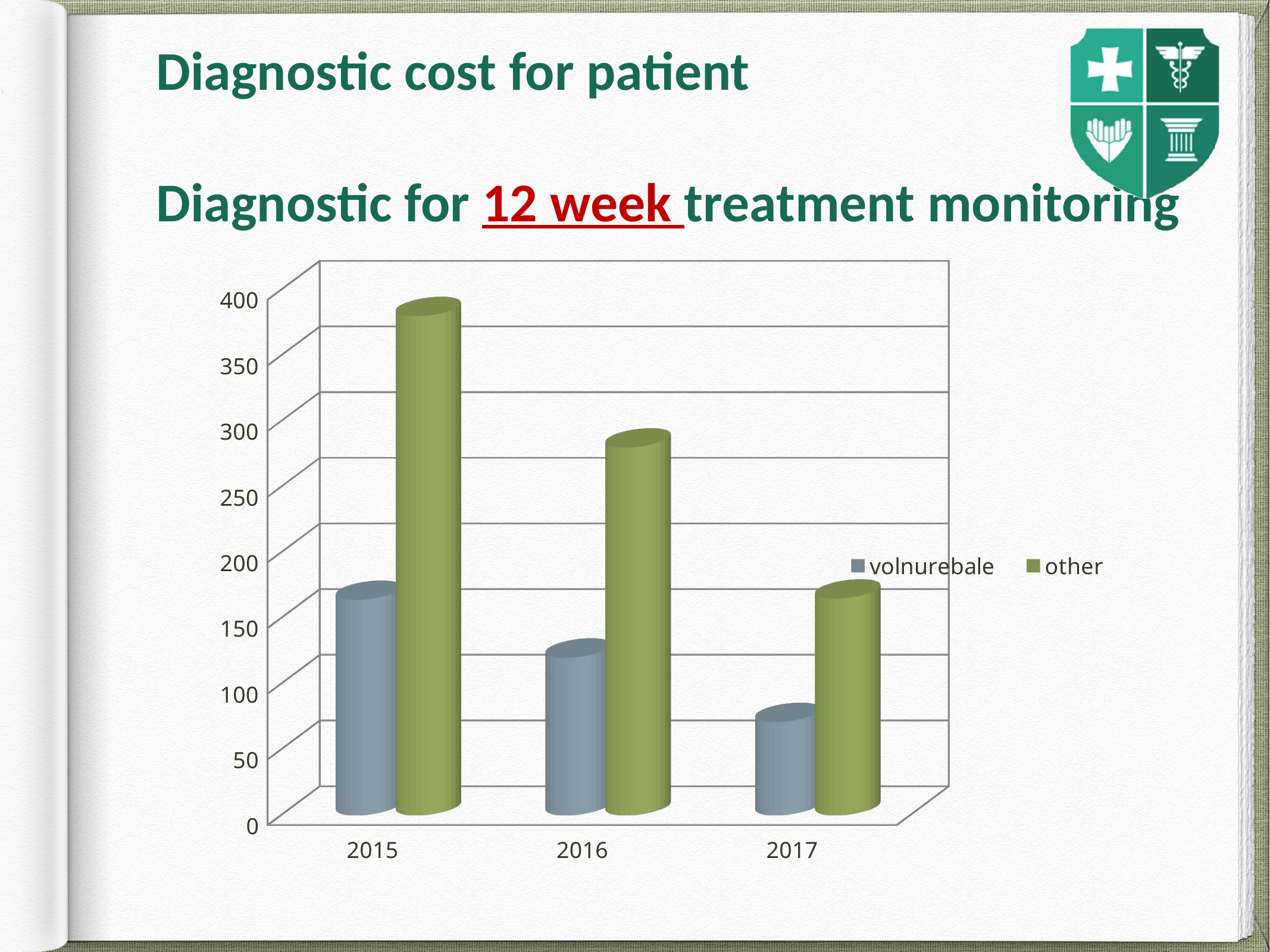
Is the value for 'other' in 2017 greater or less than 250? less Which year has the lowest value for the 'volnurebale' series? 2017 What are the two entries in the chart legend? volnurebale and other In 2015, which series has the larger value, 'volnurebale' or 'other'? other How many years are shown on the x axis? 3 Is the value for 'volnurebale' in 2017 greater or less than 150? less Is the value for 'other' in 2015 greater or less than 350? greater Which year has the highest value for the 'other' series? 2015 Do the values for the 'other' series rise or fall from 2015 to 2017? fall What kind of chart is shown on the slide? bar chart How many series does the legend list? 2